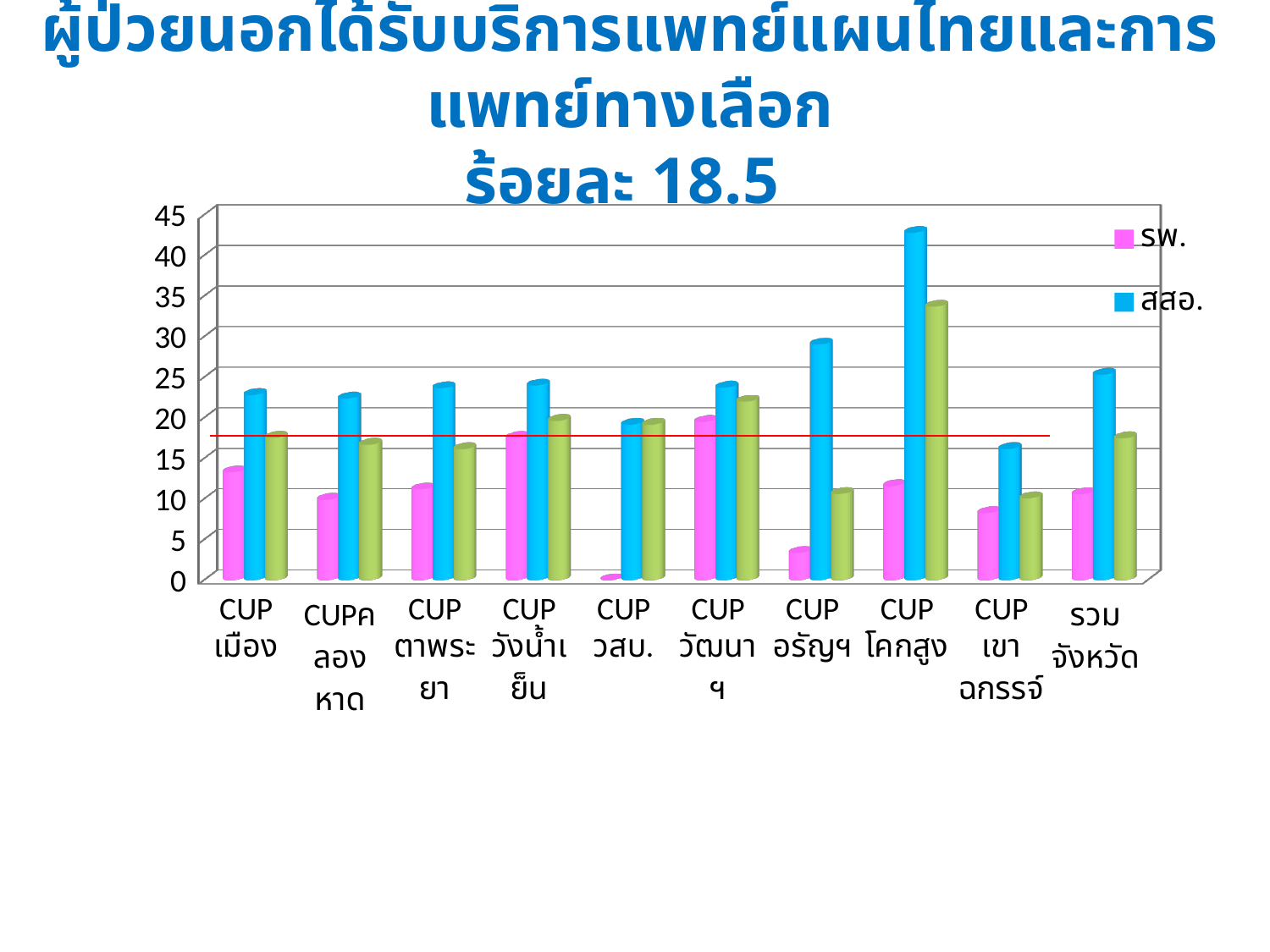
What colour represents the รพ. series in the legend? pink Which category has the highest value for สสอ.? CUP โคกสูง Is the value for สสอ. in CUP โคกสูง greater or less than 40? greater Which category has the lowest value for รพ.? CUP วสบ. Which category has the lowest value for สสอ.? CUP เขาฉกรรจ์ In CUP โคกสูง, which is larger: the value for รพ. or the value for สสอ.? สสอ. How many series does the legend list? 2 Is the value for สสอ. in CUP อรัญฯ greater or less than 25? greater What kind of chart is shown on the slide? bar chart Is the value for รพ. in CUP อรัญฯ greater or less than 5? less How many categories are shown along the x axis? 10